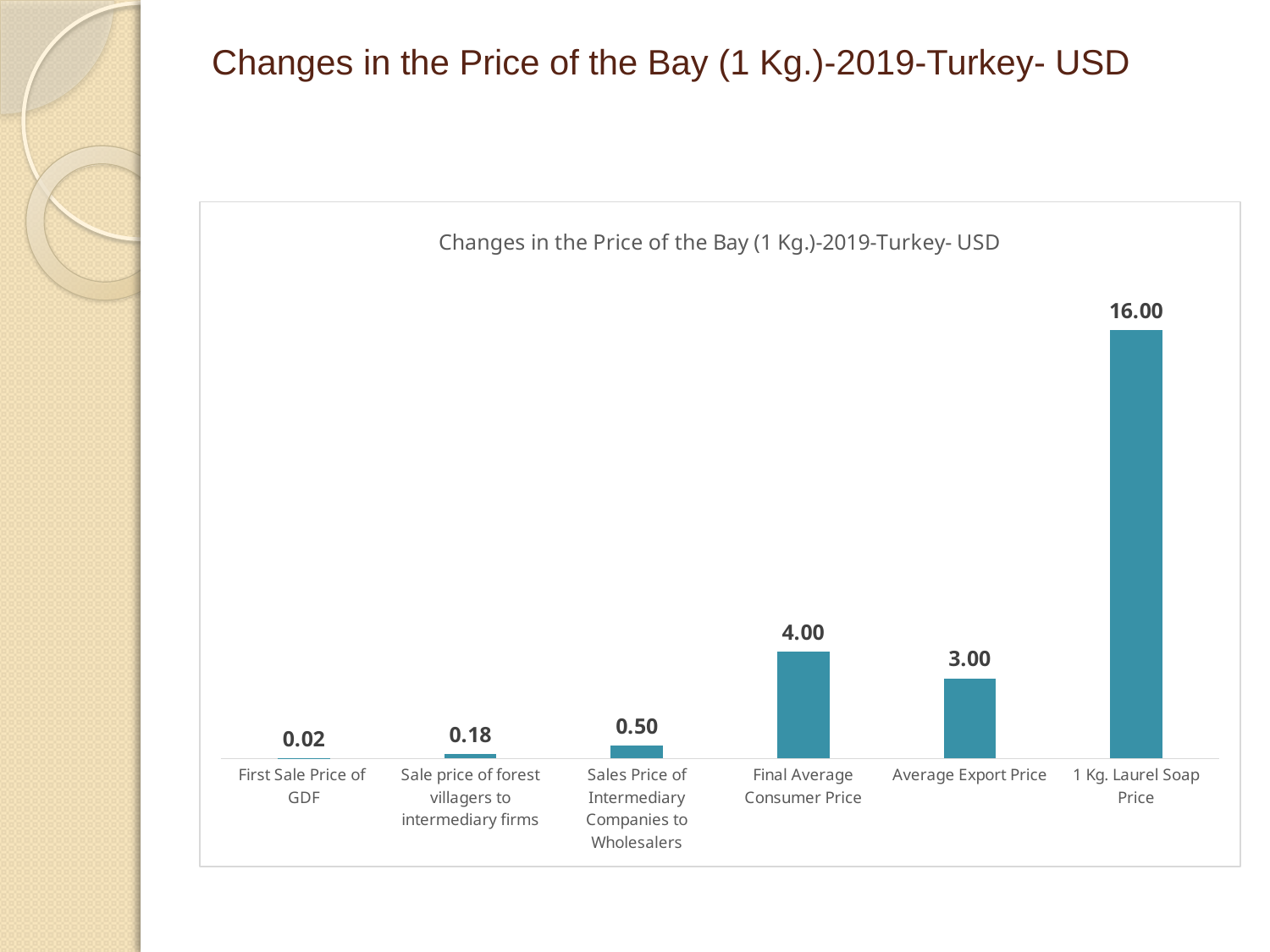
What is the title of the chart? Changes in the Price of the Bay (1 Kg.)-2019-Turkey- USD What is the value for Sales Price of Intermediary Companies to Wholesalers? 0.50 What is the value for Average Export Price? 3.00 Which category has the lowest value? First Sale Price of GDF Which is larger, the Final Average Consumer Price or the Average Export Price? Final Average Consumer Price What is the value for Sale price of forest villagers to intermediary firms? 0.18 What is the difference between the Final Average Consumer Price and the Average Export Price? 1.00 What is the value for First Sale Price of GDF? 0.02 What kind of chart is shown on the slide? Bar chart What is the difference between the 1 Kg. Laurel Soap Price and the Final Average Consumer Price? 12.00 Which category has the highest value? 1 Kg. Laurel Soap Price How many categories are shown in the chart? 6